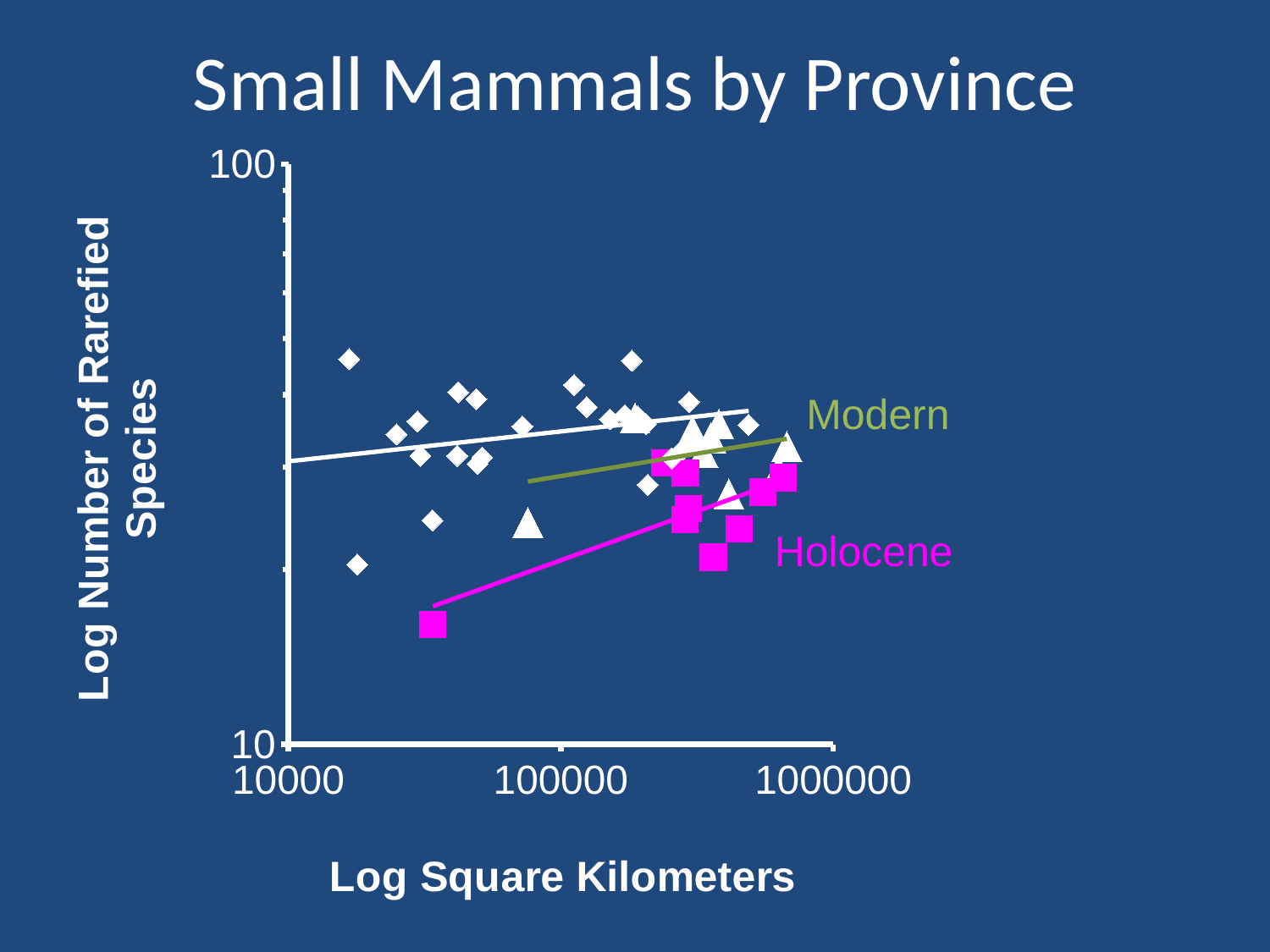
Is the leftmost Holocene point greater or less than 10000 on the x axis? greater Which two series are labelled by name next to their trend lines? Modern and Holocene What kind of chart is shown on the slide? Scatter plot Is the lowest Holocene point greater or less than 100 on the y axis? less Is the highest white diamond point greater or less than 100 on the y axis? less Does the Modern trend line rise or fall as square kilometers increase? Rises Does the Holocene trend line rise or fall as square kilometers increase? Rises What is the title of the chart? Small Mammals by Province Which series contains the lowest plotted point on the chart? Holocene Which trend line lies lower on the chart, Modern or Holocene? Holocene